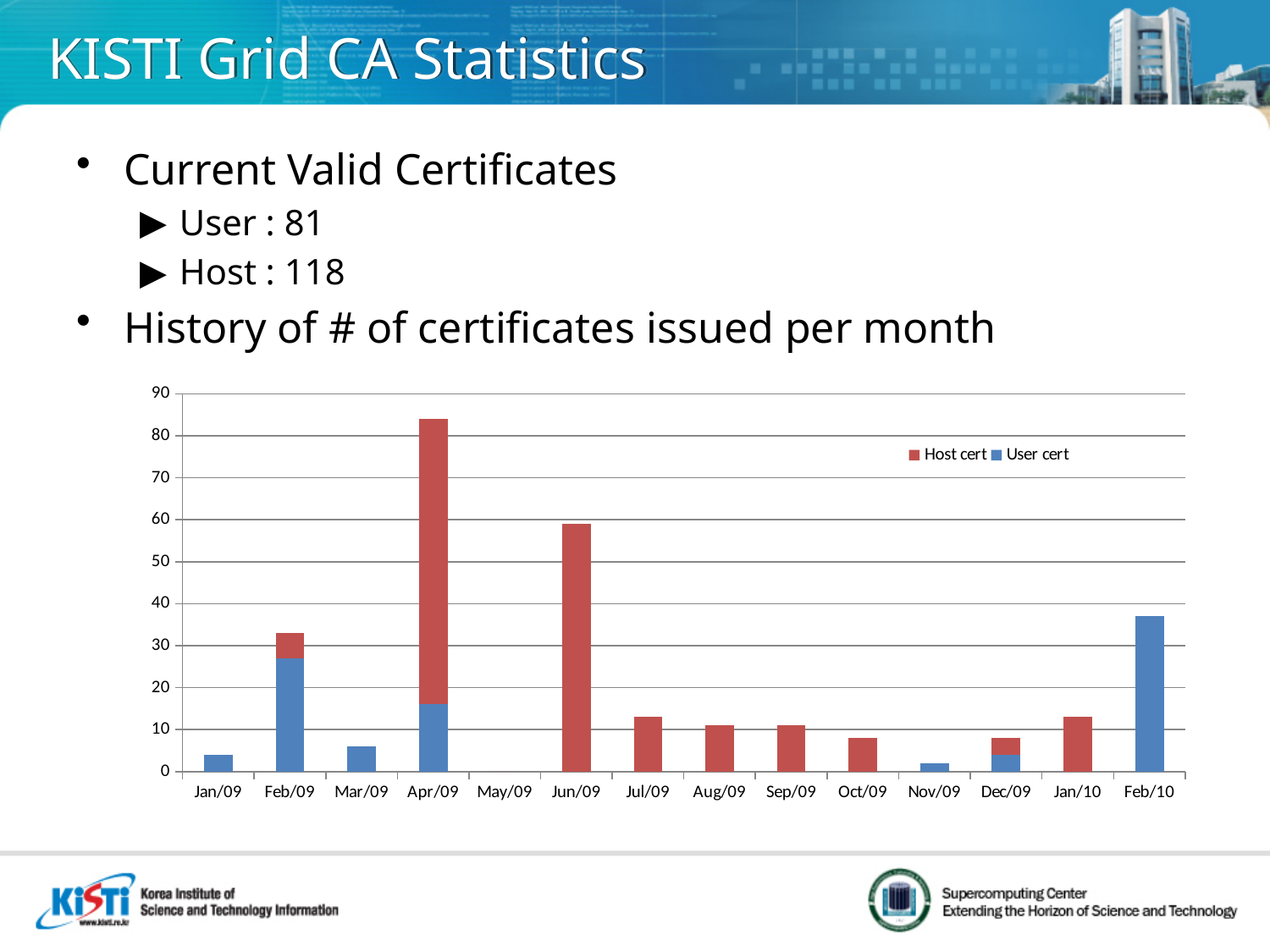
Which is larger, the total for Jun/09 or the total for Feb/10? Jun/09 Which month has the tallest User cert bar? Feb/10 Is the value for Nov/09 greater or less than 10? less Is the value for Feb/10 greater or less than 30? greater What kind of chart is shown on the slide? Stacked bar chart How many months are shown on the x axis of the chart? 14 Is the total value for Apr/09 greater or less than 70? greater Which series is shown in red in the chart? Host cert How many series does the chart legend list? 2 Which month has the lowest total number of certificates issued? May/09 Which month has the highest total number of certificates issued? Apr/09